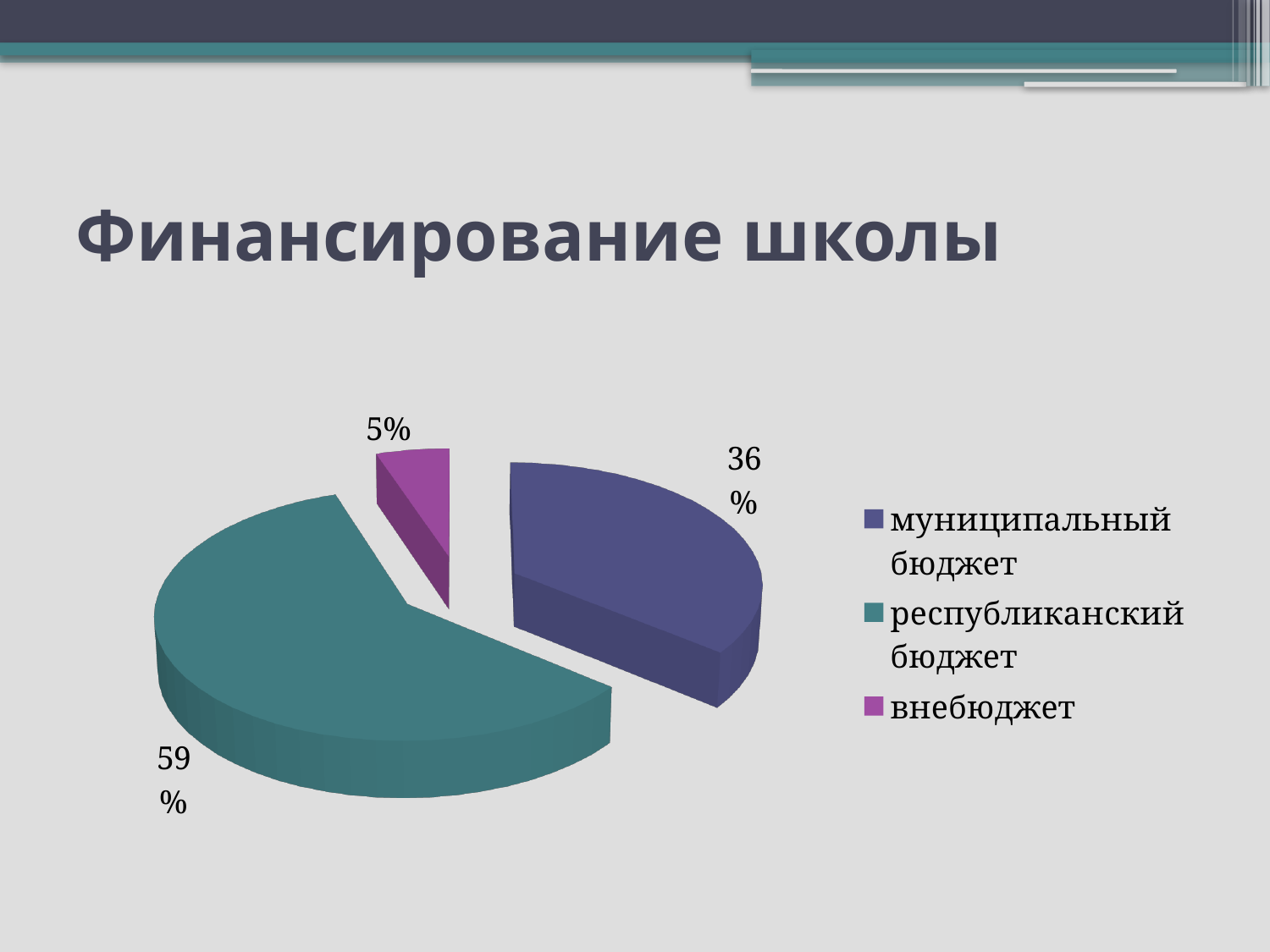
Which category has the largest slice of the pie? республиканский бюджет What kind of chart is shown on the slide? pie chart Which category has the smallest slice of the pie? внебюджет What share of the pie does the внебюджет slice represent? 5% Which is larger, the муниципальный бюджет slice or the внебюджет slice? муниципальный бюджет What is the difference in percentage points between the муниципальный бюджет and внебюджет slices? 31 What share of the pie does the республиканский бюджет slice represent? 59% What is the title of the slide containing the chart? Финансирование школы What is the difference in percentage points between the республиканский бюджет and муниципальный бюджет slices? 23 What share of the pie does the муниципальный бюджет slice represent? 36% What colour is the внебюджет slice in the pie chart? purple How many categories does the pie chart show? 3